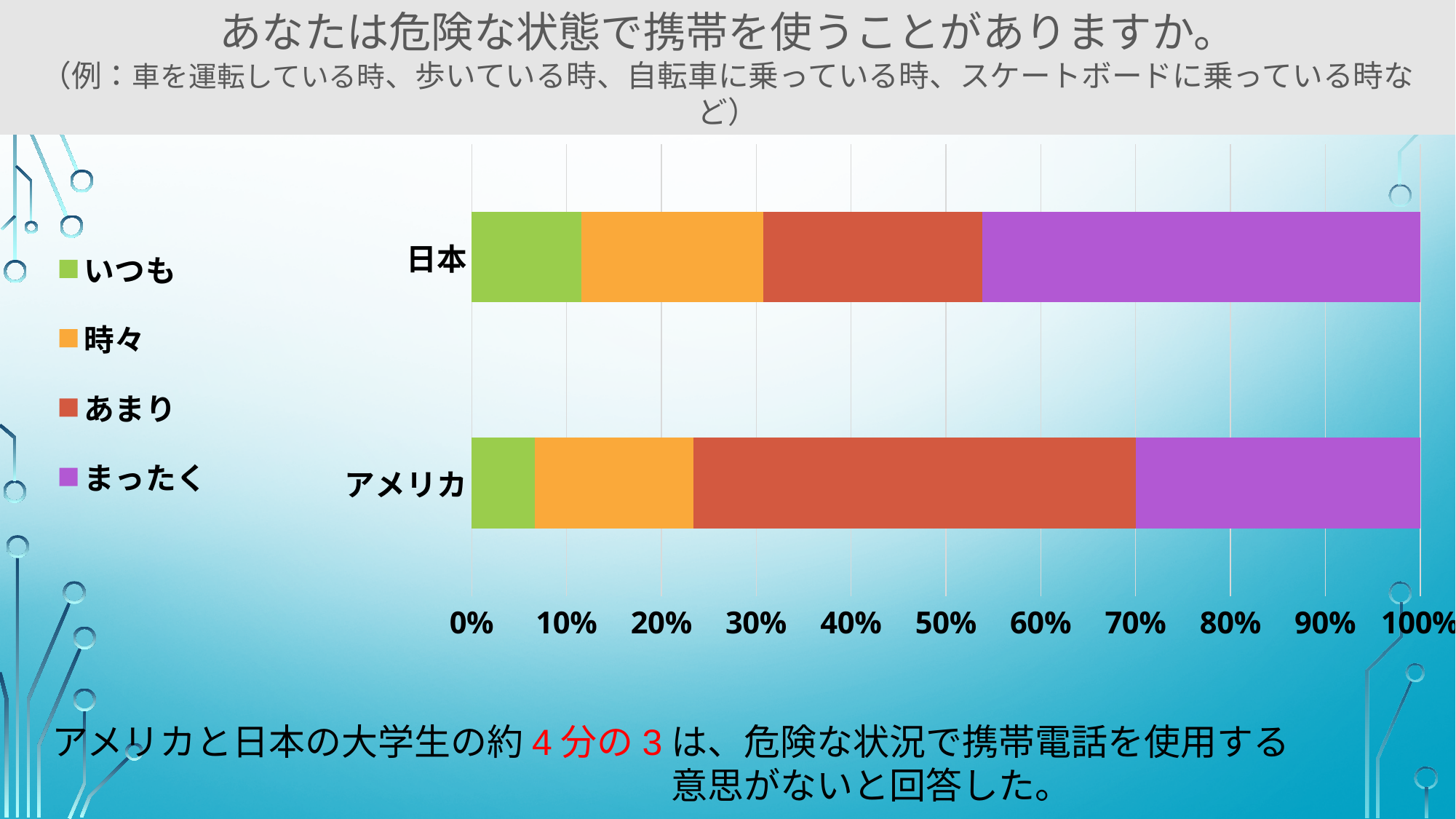
Is the share for まったく in the 日本 bar greater or less than 40%? greater Which response segment is the smallest in the アメリカ bar? いつも Which legend entry is shown in purple? まったく Is the share for いつも in the アメリカ bar greater or less than 10%? less Which response segment is the largest in the 日本 bar? まったく Which response segment is the largest in the アメリカ bar? あまり How many categories (countries) are plotted in the chart? 2 Which country has the larger share for あまり, 日本 or アメリカ? アメリカ How many series does the legend list? 4 Which country has the larger share for まったく, 日本 or アメリカ? 日本 Is the share for あまり in the アメリカ bar greater or less than 40%? greater What kind of chart is shown on the slide? stacked bar chart